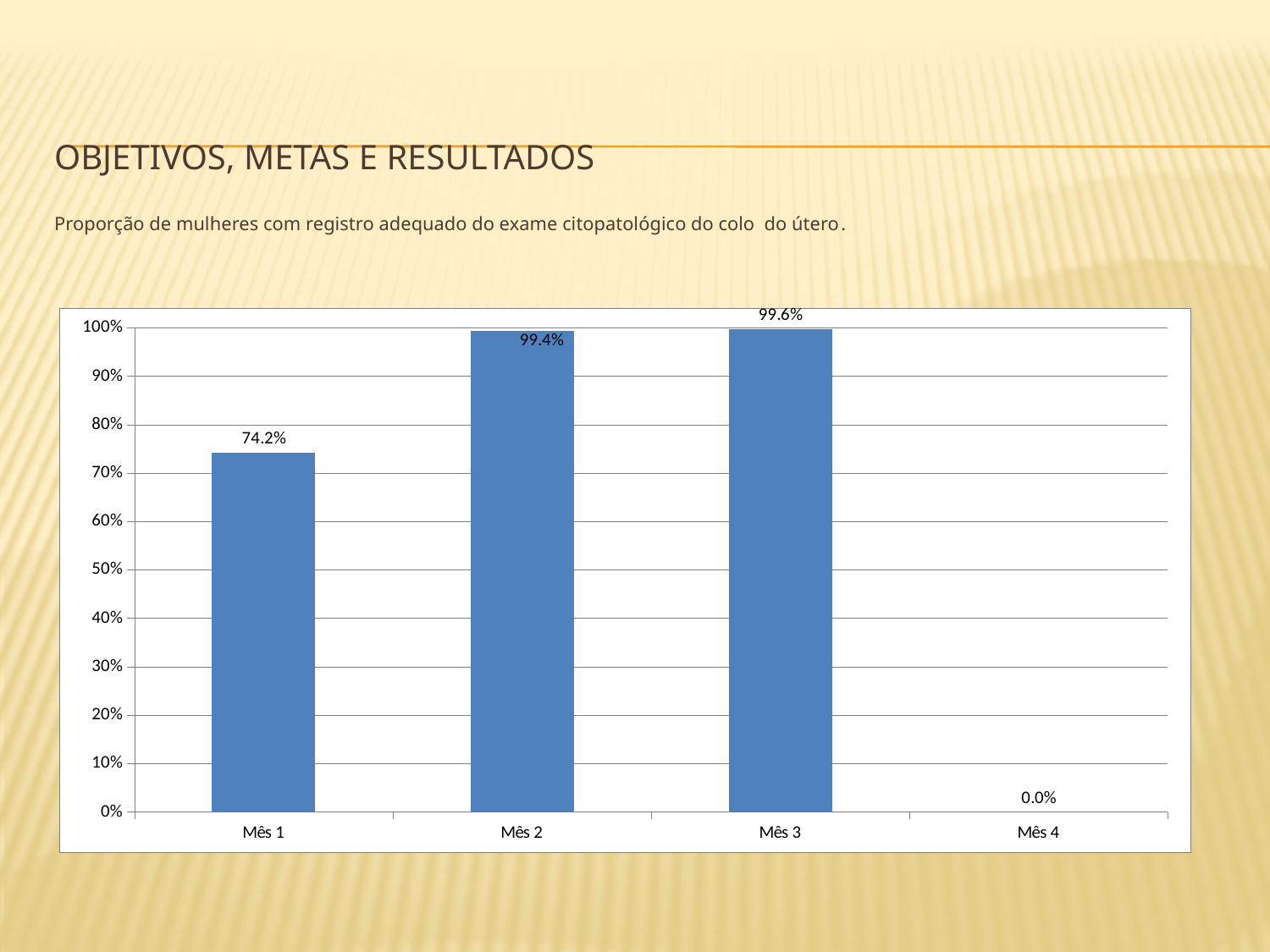
What is the value for Mês 3? 99.6% What kind of chart is shown on the slide? bar chart What is the value for Mês 2? 99.4% What is the value for Mês 1? 74.2% How many categories are shown on the x axis? 4 Which is larger, the value for Mês 1 or the value for Mês 2? Mês 2 What is the value for Mês 4? 0.0% What is the difference between the values for Mês 2 and Mês 1? 25.2% Is the value for Mês 1 greater or less than 70%? greater Which month has the lowest value? Mês 4 What is the difference between the values for Mês 3 and Mês 2? 0.2% Which month has the highest value? Mês 3